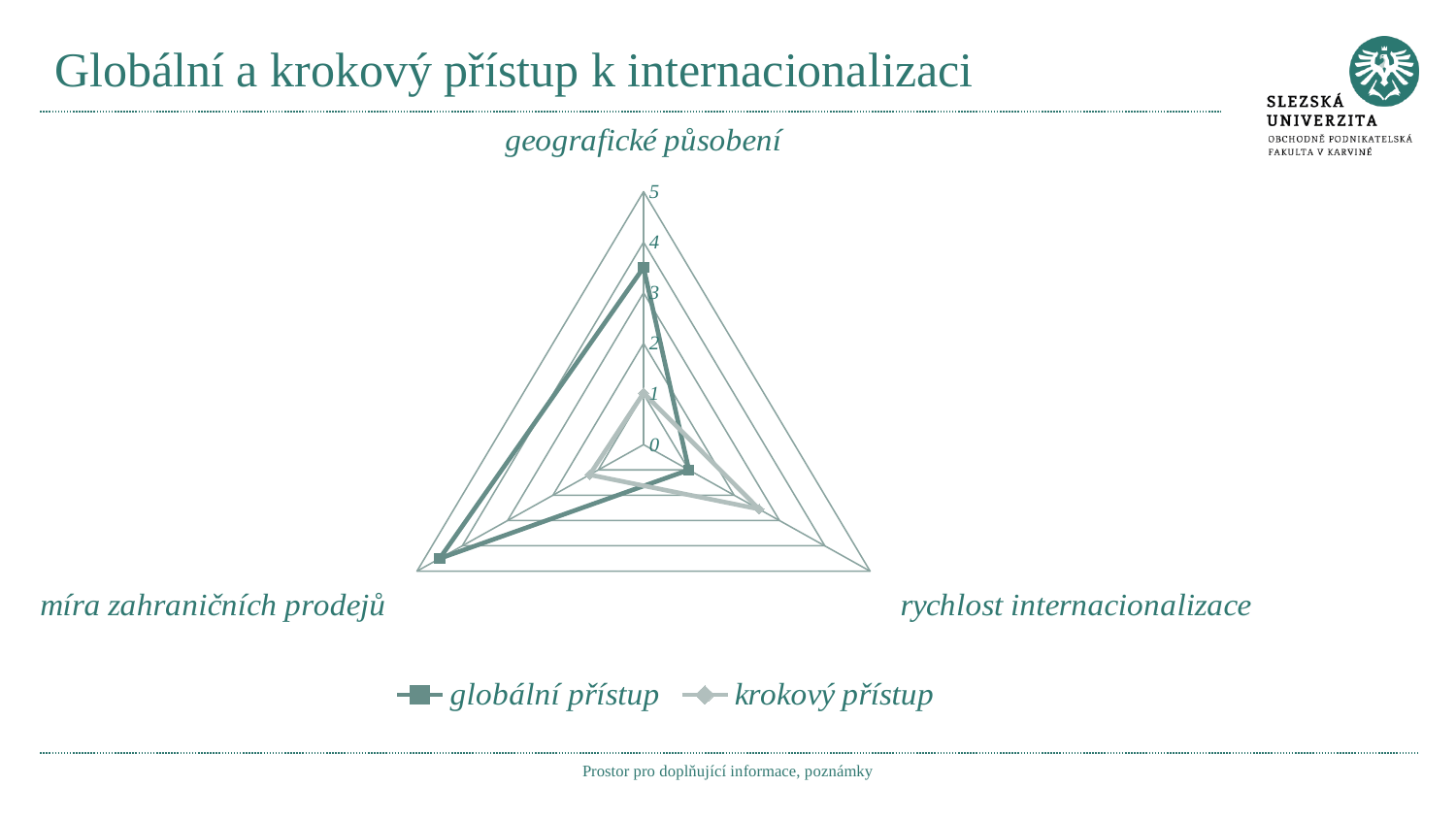
Is the value of krokový přístup for rychlost internacionalizace greater or less than 2? greater On which axis does globální přístup reach its highest value? míra zahraničních prodejů Which series has the higher value for geografické působení? globální přístup Is the value of globální přístup for míra zahraničních prodejů greater or less than 4? greater How many axes (categories) does the radar chart have? 3 What are the two series named in the legend? globální přístup, krokový přístup Is the value of globální přístup for rychlost internacionalizace greater or less than 2? less What kind of chart is shown on the slide? radar chart How many series does the legend list? 2 Which series has the higher value for rychlost internacionalizace? krokový přístup